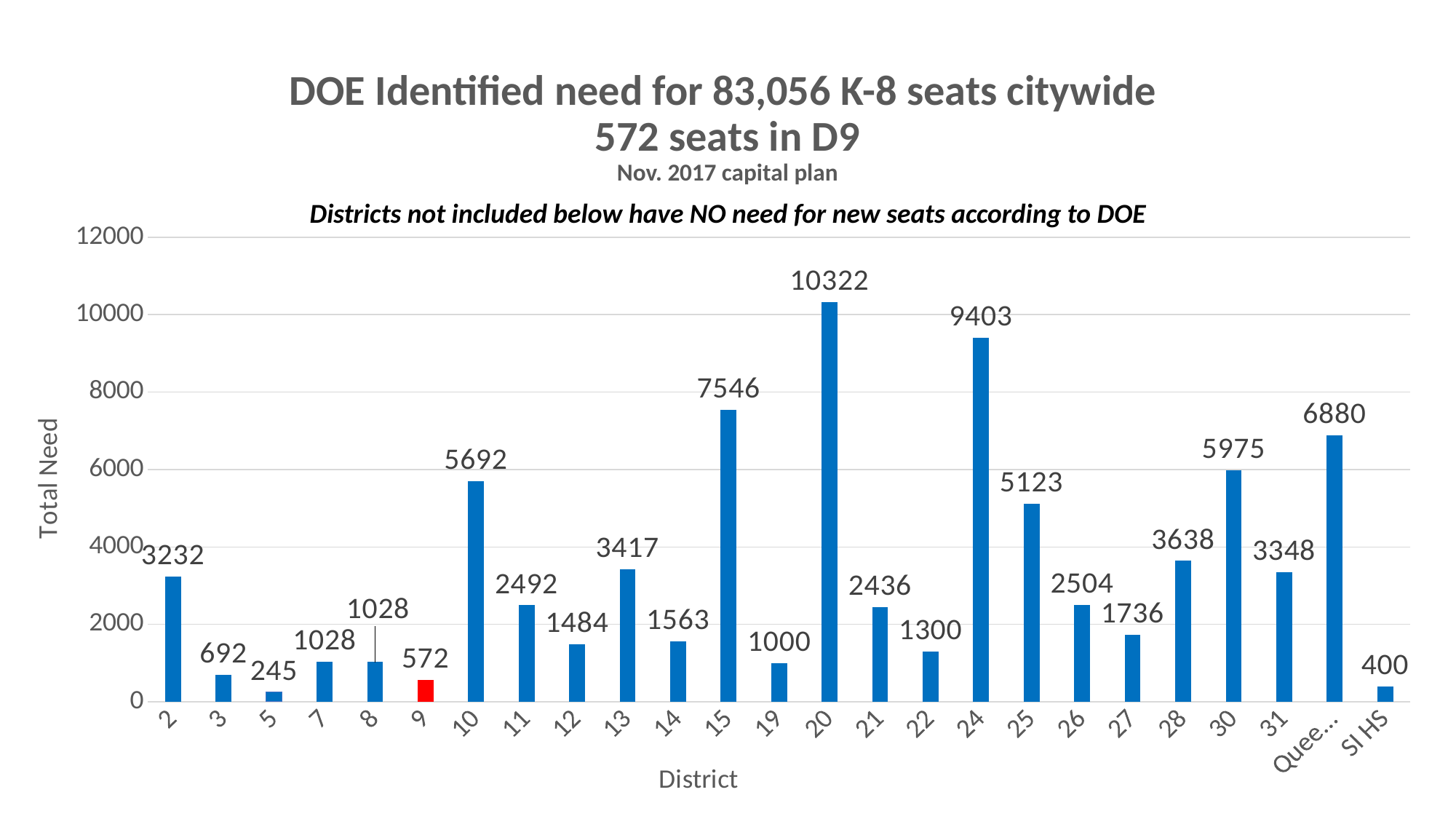
What is the total need for district 20? 10322 Which district has the highest total need? 20 What is the total need for SI HS? 400 Which has a larger total need, district 10 or district 30? 30 What is the total need for district 15? 7546 What kind of chart is shown on the slide? bar chart Is the value for district 28 greater or less than 4000? less Which bar is coloured red instead of blue? 9 What is the difference in total need between district 20 and district 24? 919 How many districts are shown on the x axis? 25 Which district has the lowest total need? 5 What is the total need for district 9? 572